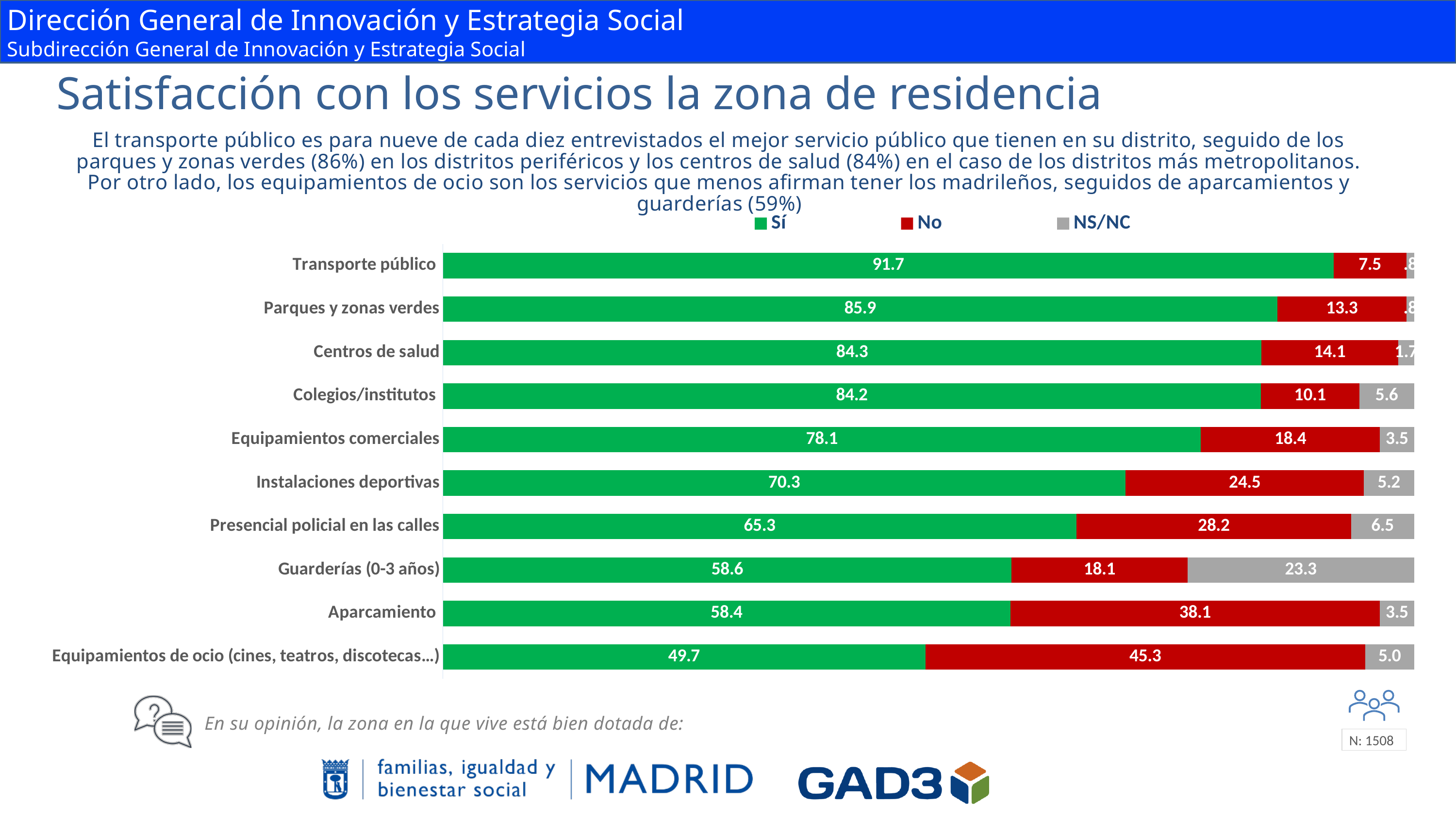
How many categories are shown in the chart? 10 What is the difference between the "Sí" values for Transporte público and Parques y zonas verdes? 5.8 Which is larger, the "No" value for Instalaciones deportivas or for Equipamientos comerciales? Instalaciones deportivas Which category has the highest "No" value? Equipamientos de ocio (cines, teatros, discotecas…) Which colour represents the "No" series in the chart? Red How many series does the legend list? 3 What is the "Sí" value for Transporte público? 91.7 Which category has the highest "Sí" value? Transporte público What is the "NS/NC" value for Guarderías (0-3 años)? 23.3 What kind of chart is shown on the slide? Stacked bar chart Which category has the lowest "Sí" value? Equipamientos de ocio (cines, teatros, discotecas…) What is the "No" value for Aparcamiento? 38.1